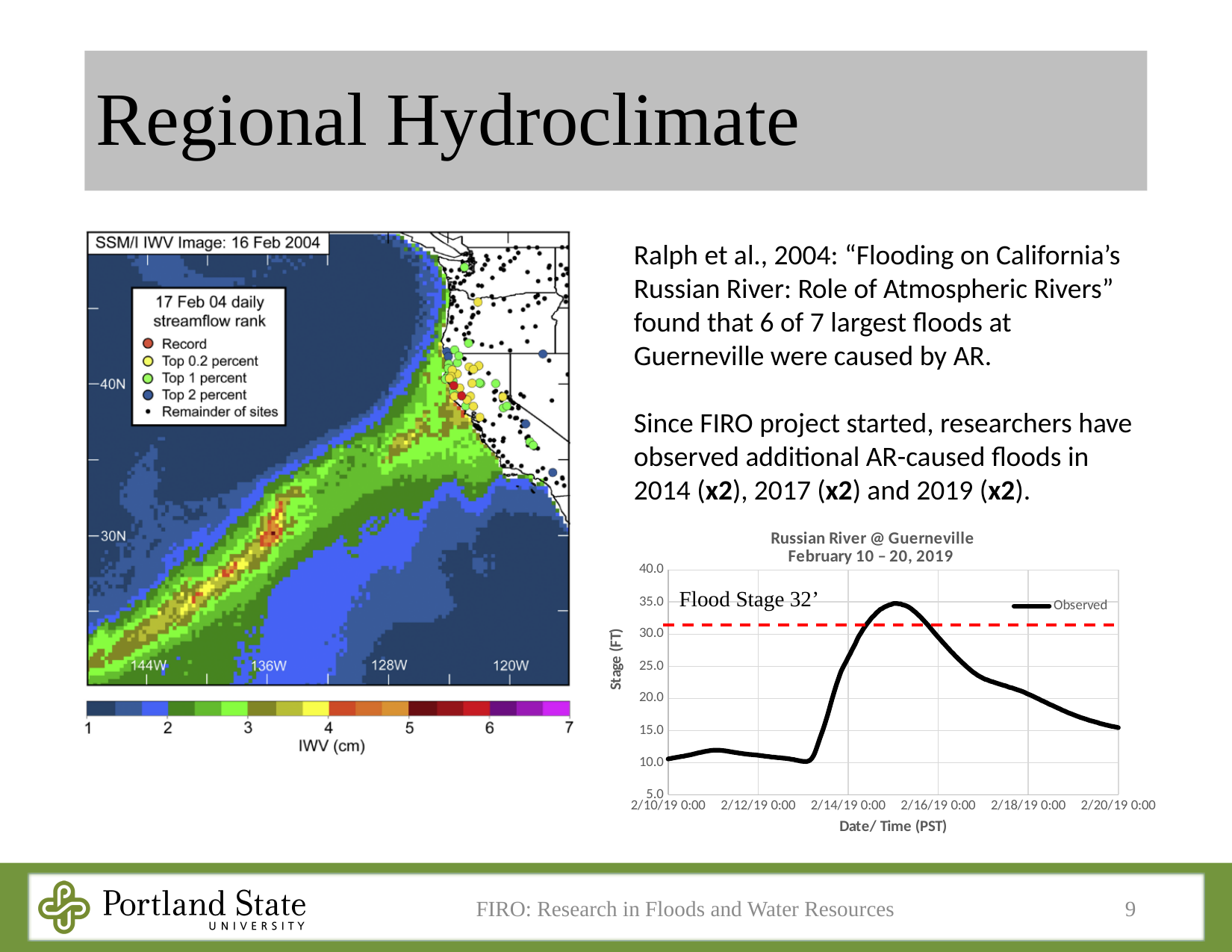
What kind of chart is the 'Russian River @ Guerneville' chart? line chart In the 'Russian River @ Guerneville' chart, which is larger: the stage at 2/10/19 0:00 or the stage at 2/20/19 0:00? 2/20/19 0:00 In the 'Russian River @ Guerneville' chart, does the stage rise or fall between 2/14/19 0:00 and the peak? rise How many series does the legend of the 'Russian River @ Guerneville' chart list? 1 In the 'Russian River @ Guerneville' chart, is the stage at 2/20/19 0:00 greater or less than 20? less What is the y-axis label of the 'Russian River @ Guerneville' chart? Stage (FT) In the 'Russian River @ Guerneville' chart, is the stage at 2/12/19 0:00 greater or less than 15? less What is the name of the series in the legend of the 'Russian River @ Guerneville' chart? Observed In the 'Russian River @ Guerneville' chart, is the peak stage value greater or less than 30? greater In the 'Russian River @ Guerneville' chart, does the stage rise or fall between 2/16/19 0:00 and 2/20/19 0:00? fall